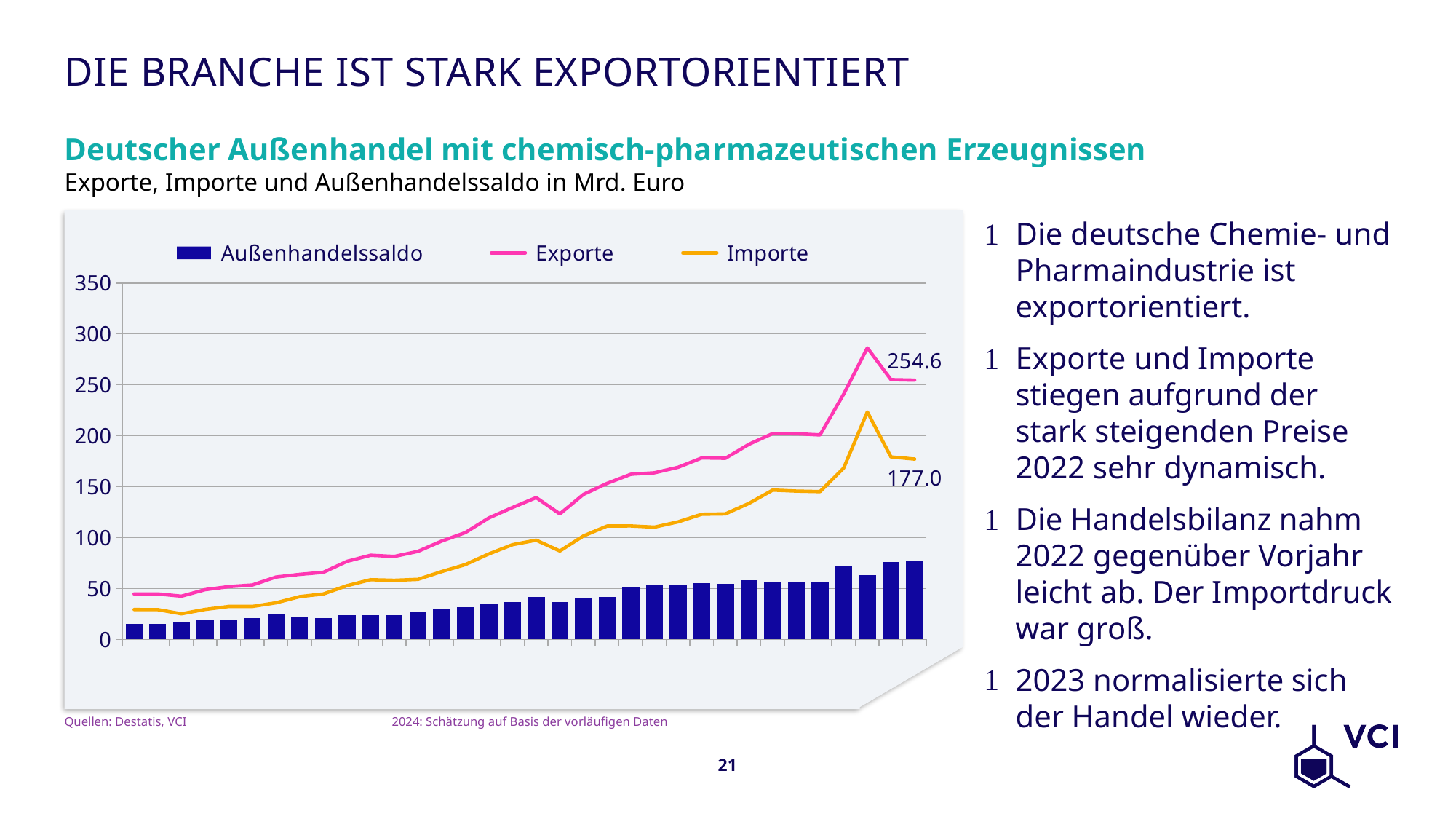
What is the labelled final value of the Importe line? 177.0 What is the highest value shown on the y axis? 350 How many series does the legend list? 3 What is the labelled final value of the Exporte line? 254.6 At the end of the series, which is larger: Exporte or Importe? Exporte Which series is plotted as bars? Außenhandelssaldo Do the Exporte values generally rise or fall along the x axis? rise Is the first Außenhandelssaldo bar greater or less than 50? less Is the peak value of the Importe line greater or less than 200? greater Is the peak value of the Exporte line greater or less than 250? greater What kind of chart is shown? Combined bar and line chart What is the difference between the labelled final values of Exporte (254.6) and Importe (177.0)? 77.6